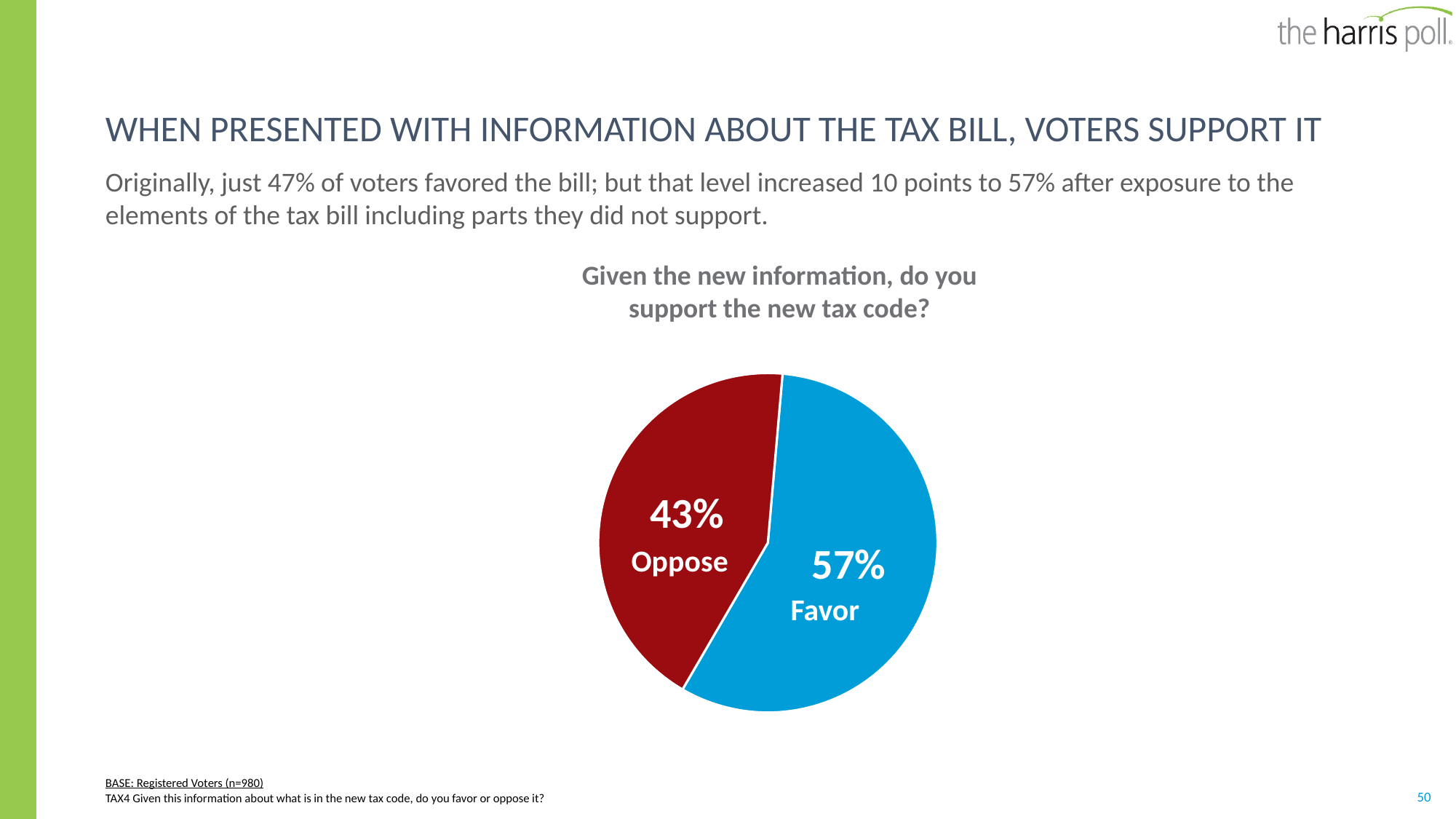
What percentage of voters favor the new tax code? 57% What is the total of the two slices shown in the pie chart? 100% What share of the pie does the Favor slice represent? 57% Which slice of the pie is the smallest? Oppose What kind of chart is shown on the slide? Pie chart How many slices does the pie chart have? 2 What is the difference in percentage points between Favor and Oppose? 14 What percentage of voters oppose the new tax code? 43% Which is larger, the Favor share or the Oppose share? Favor What colour is the Oppose slice? Red Which slice of the pie is the largest? Favor What is the title of the chart? Given the new information, do you support the new tax code?